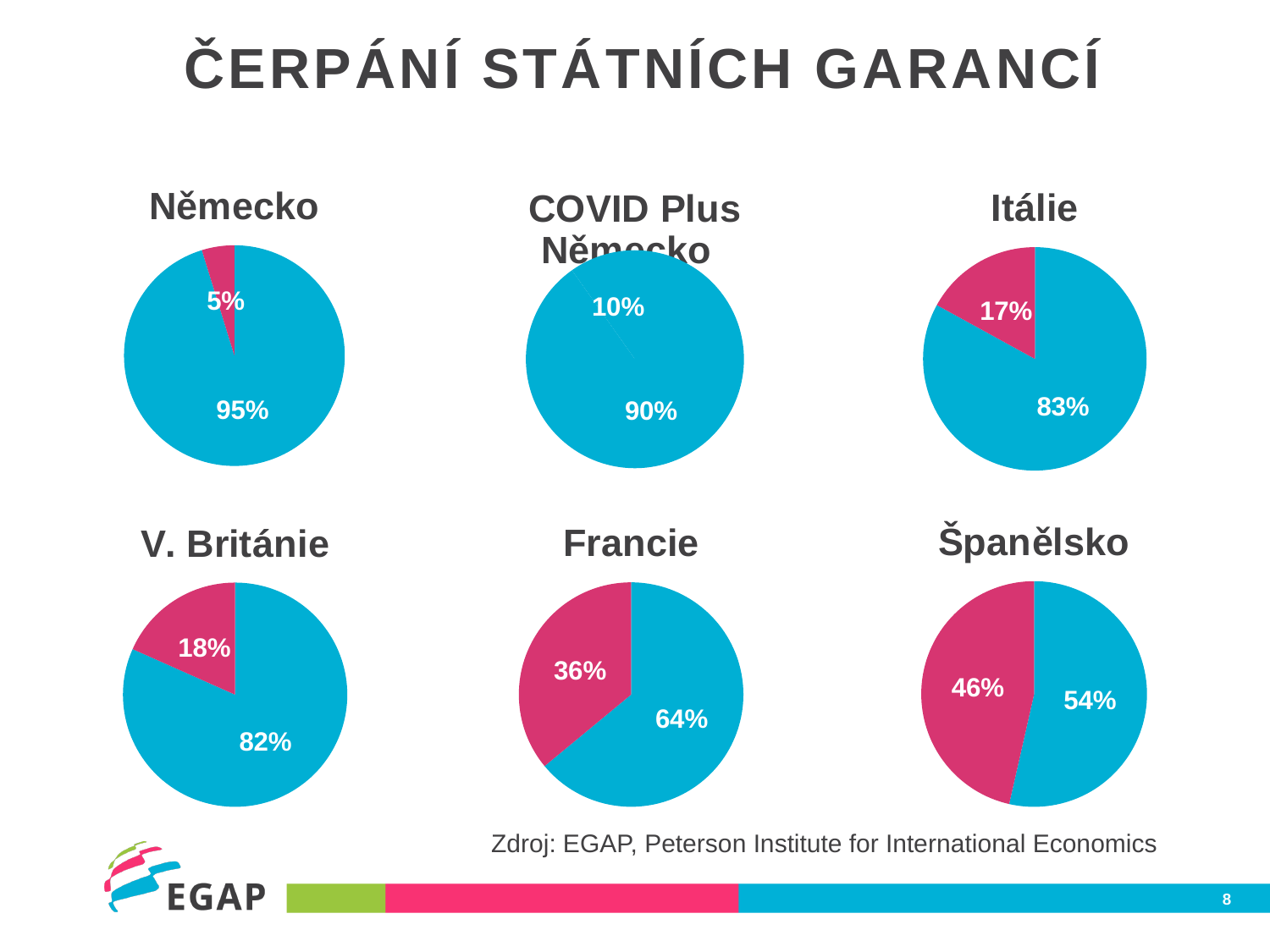
What is the difference between the pink slice in the Francie pie chart and the pink slice in the Itálie pie chart? 19% In the COVID Plus Německo pie chart, what share does the blue slice represent? 90% What kind of chart is used for each country on this slide? Pie chart Which pie chart has the largest pink slice? Španělsko In the Španělsko pie chart, what share does the blue slice represent? 54% In the Německo pie chart, what share does the pink slice represent? 5% How many pie charts are shown on the slide? 6 Which pie chart has the smallest pink slice? Německo